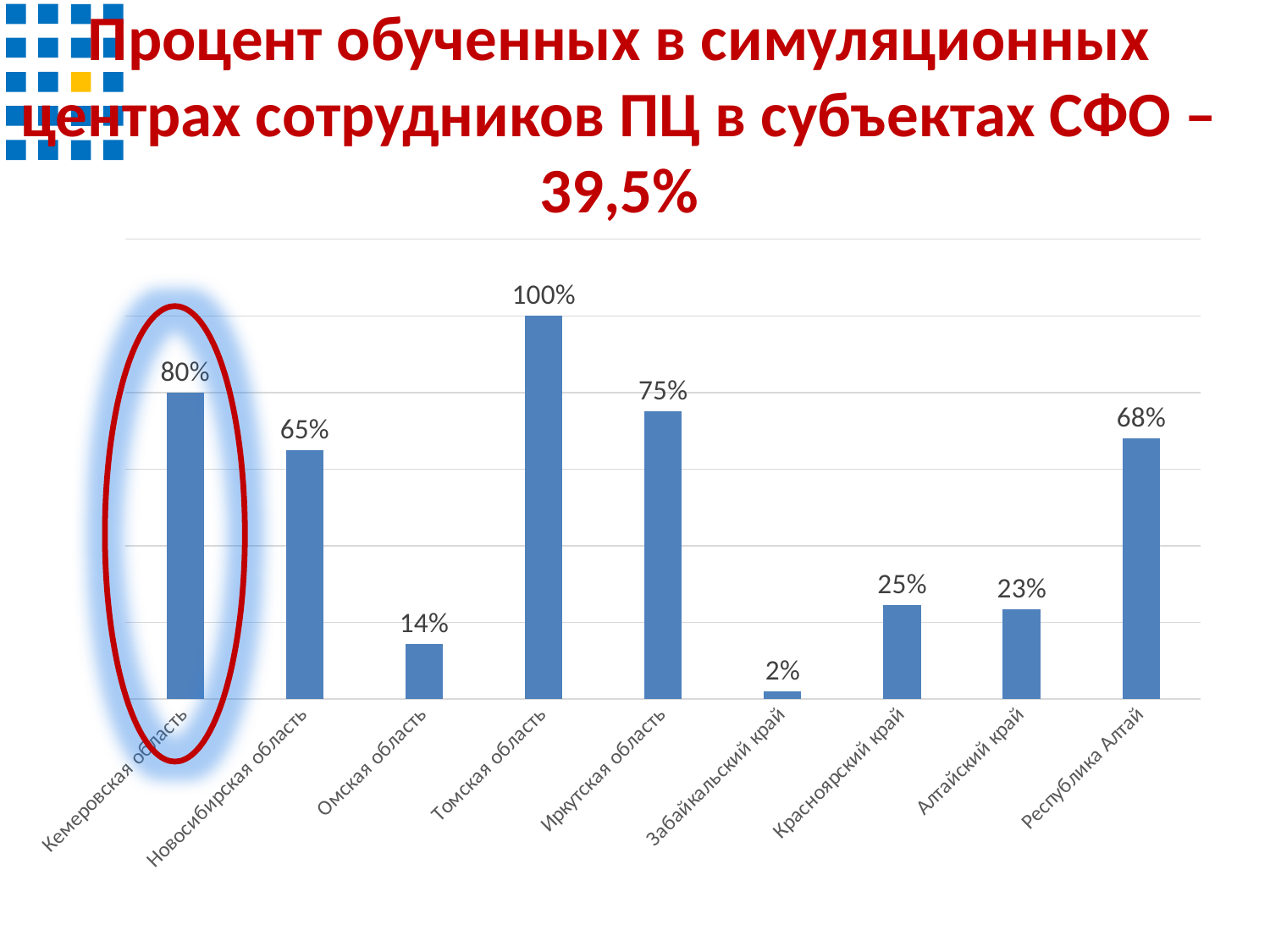
What kind of chart is shown on the slide? Bar chart Which region's bar is circled in red on the chart? Кемеровская область What is the difference between the values for Кемеровская область and Новосибирская область? 15% Which is larger, the value for Красноярский край or Алтайский край? Красноярский край Which region has the lowest value? Забайкальский край Which is larger, the value for Омская область or Республика Алтай? Республика Алтай What is the value for Забайкальский край? 2% What is the difference between the values for Томская область and Иркутская область? 25% What is the value for Кемеровская область? 80% What is the value for Республика Алтай? 68% How many regions are shown on the chart? 9 Which region has the highest value? Томская область